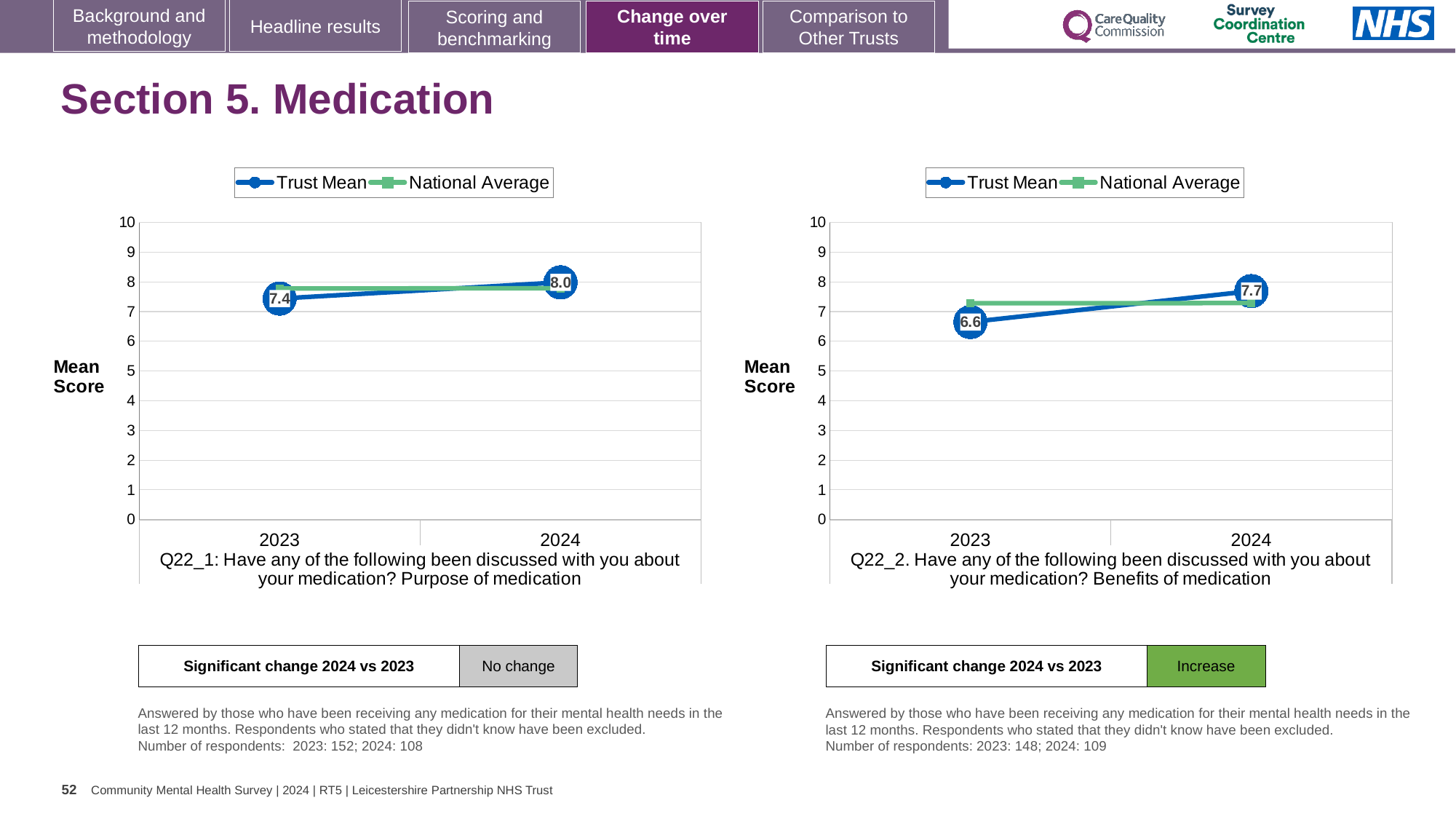
In the Q22_2 chart (Benefits of medication), is the Trust Mean higher in 2023 or in 2024? 2024 In the Q22_2 chart (Benefits of medication), by how much did the Trust Mean change from 2023 to 2024? 1.1 In the Q22_2 chart (Benefits of medication), is the National Average for 2023 greater or less than 7? greater In the Q22_1 chart (Purpose of medication), does the Trust Mean rise or fall from 2023 to 2024? rise In the Q22_1 chart (Purpose of medication), what is the Trust Mean for 2023? 7.4 In the Q22_2 chart (Benefits of medication), what is the Trust Mean for 2024? 7.7 In the Q22_1 chart (Purpose of medication), what is the difference between the Trust Mean in 2024 and in 2023? 0.6 How many series does the legend of the Q22_2 chart (Benefits of medication) list? 2 What type of chart is the Q22_1 chart (Purpose of medication)? line chart In the Q22_2 chart (Benefits of medication), what is the Trust Mean for 2023? 6.6 In the Q22_1 chart (Purpose of medication), what is the Trust Mean for 2024? 8.0 How many years are shown on the x axis of the Q22_1 chart (Purpose of medication)? 2